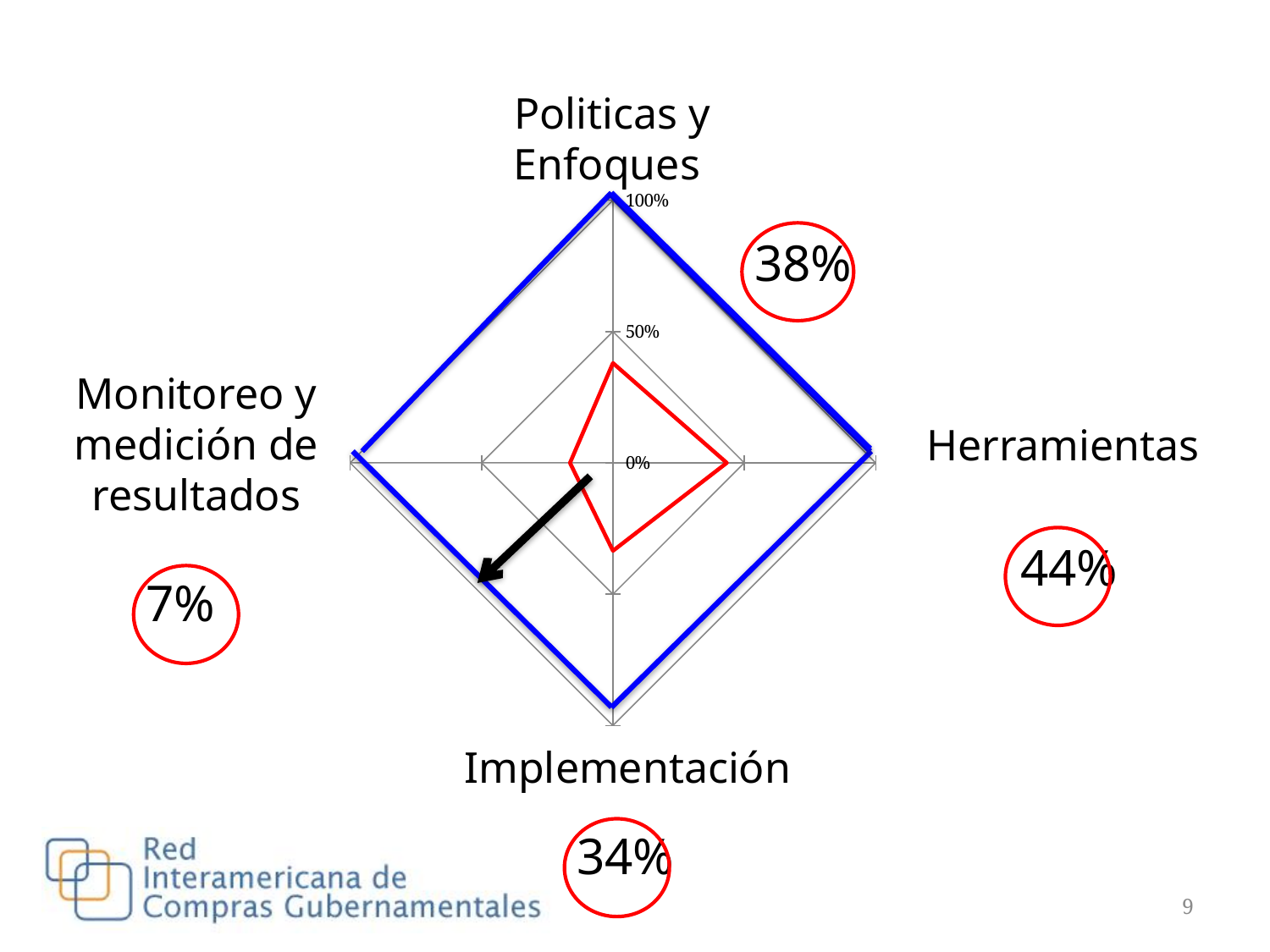
What value does the outer blue line on the radar chart correspond to? 100% Which category has the highest value? Herramientas What is the value shown for Politicas y Enfoques? 38% Which category has the lowest value? Monitoreo y medición de resultados What is the value shown for Monitoreo y medición de resultados? 7% Which is larger, the value for Politicas y Enfoques or the value for Implementación? Politicas y Enfoques What is the value shown for Herramientas? 44% How many axes (categories) does the radar chart have? 4 What type of chart is shown on the slide? Radar chart What is the value shown for Implementación? 34% What is the difference between the values for Herramientas and Monitoreo y medición de resultados? 37 percentage points Is the value for Politicas y Enfoques greater or less than 50%? less